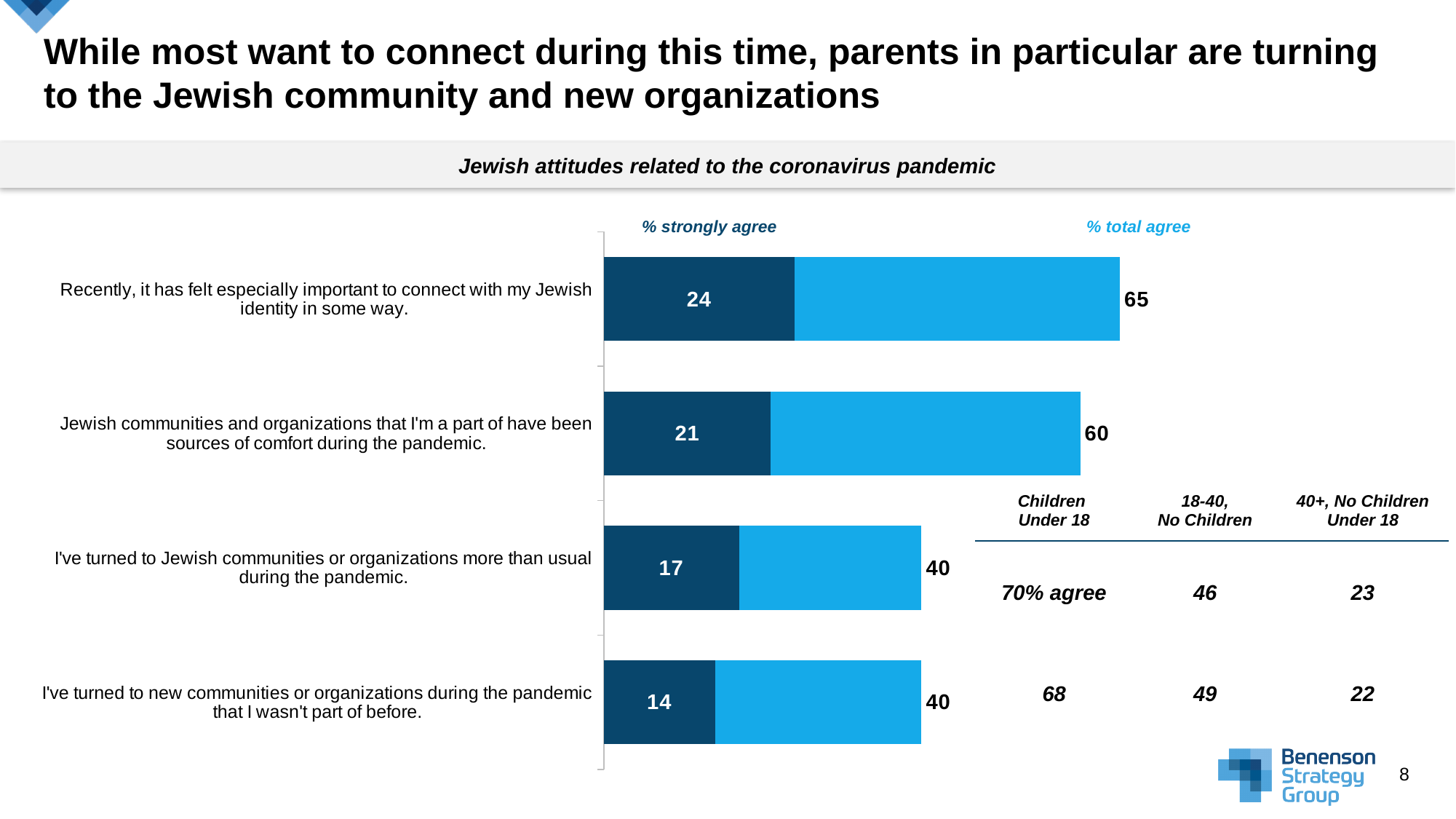
What is the % strongly agree value for "Recently, it has felt especially important to connect with my Jewish identity in some way"? 24 What is the difference in % strongly agree between "Recently, it has felt especially important to connect with my Jewish identity in some way" and "I've turned to new communities or organizations during the pandemic that I wasn't part of before"? 10 What is the % total agree value for "I've turned to Jewish communities or organizations more than usual during the pandemic"? 40 Which has a higher % strongly agree: "Jewish communities and organizations that I'm a part of have been sources of comfort during the pandemic" or "I've turned to Jewish communities or organizations more than usual during the pandemic"? Jewish communities and organizations that I'm a part of have been sources of comfort during the pandemic. What is the % total agree value for "Jewish communities and organizations that I'm a part of have been sources of comfort during the pandemic"? 60 How many statements are shown in the chart? 4 What kind of chart is shown on the slide? Bar chart What is the difference in % total agree between "Recently, it has felt especially important to connect with my Jewish identity in some way" and "Jewish communities and organizations that I'm a part of have been sources of comfort during the pandemic"? 5 How many series does the chart show? 2 Which statement has the highest % total agree? Recently, it has felt especially important to connect with my Jewish identity in some way. Which statement has the lowest % strongly agree? I've turned to new communities or organizations during the pandemic that I wasn't part of before. What is the title of the chart? Jewish attitudes related to the coronavirus pandemic